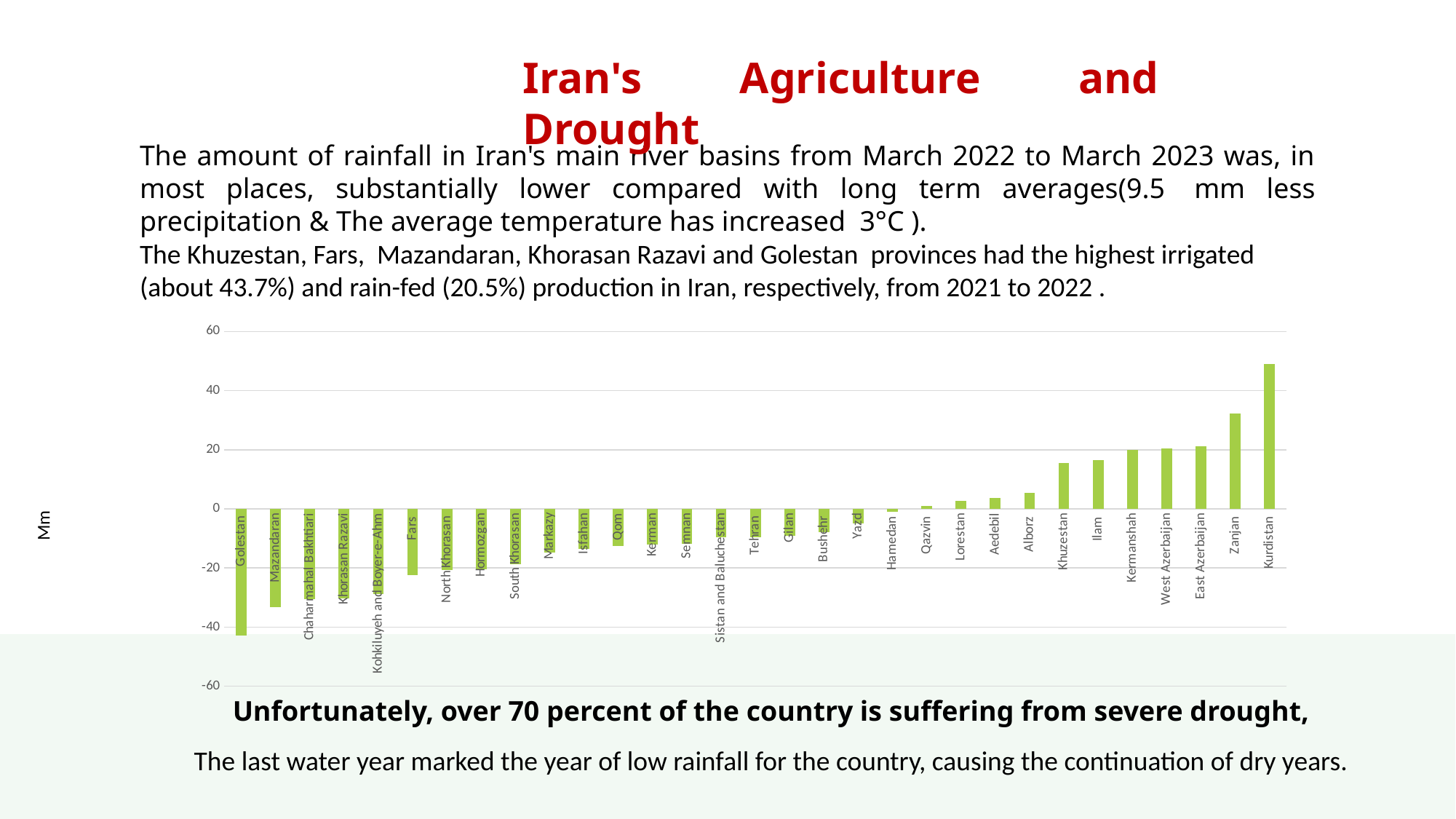
Is the value for Golestan greater or less than -40? less Is the value for Mazandaran greater or less than -20? less Which province has the highest value in the chart? Kurdistan Which province has the lowest value in the chart? Golestan What kind of chart is shown on the slide? bar chart Is the value for Kurdistan greater or less than 40? greater How many provinces are shown in the chart? 31 Which has the larger value, Zanjan or Kurdistan? Kurdistan Which has the larger value, Fars or Alborz? Alborz Do the bar values generally rise or fall from left to right along the x axis? rise